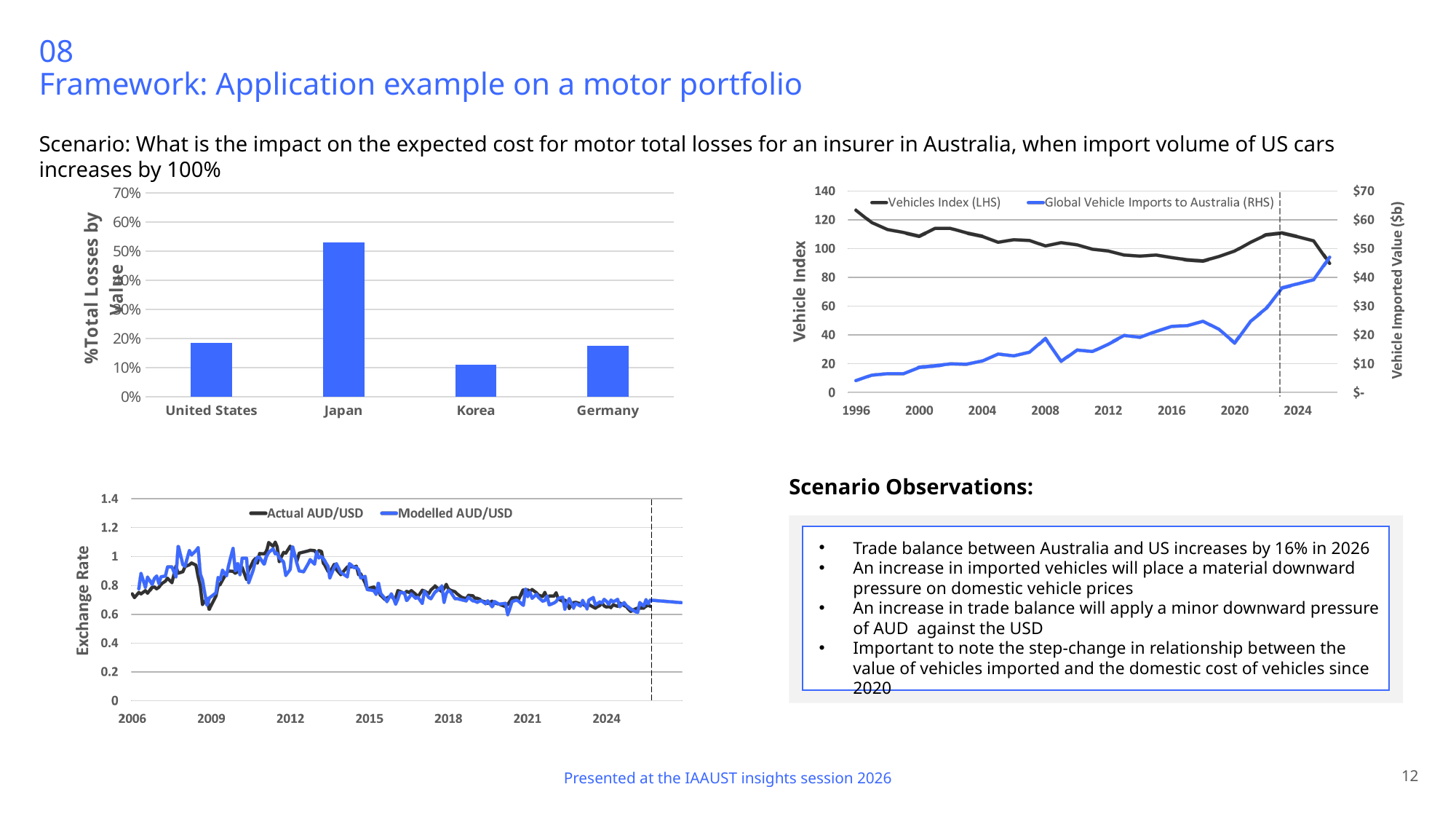
What kind of chart is the top-left chart showing % Total Losses by Value? bar chart In the top-left bar chart of % Total Losses by Value, which country has the highest value? Japan In the top-left bar chart, is the value for United States greater or less than 30%? less In the top-left bar chart, which is larger: the value for Japan or the value for Germany? Japan How many series does the legend of the top-right Vehicle Index chart list? 2 In the bottom-left Exchange Rate chart, what are the two series listed in the legend? Actual AUD/USD and Modelled AUD/USD What is the y-axis label of the bottom-left line chart? Exchange Rate In the top-right chart, does the Global Vehicle Imports to Australia (RHS) series generally rise or fall from 1996 to 2024? rise In the top-left bar chart of % Total Losses by Value, which country has the lowest value? Korea How many countries are shown in the top-left bar chart? 4 In the top-left bar chart, is the value for Korea greater or less than 20%? less In the top-left bar chart, is the value for Japan greater or less than 50%? greater